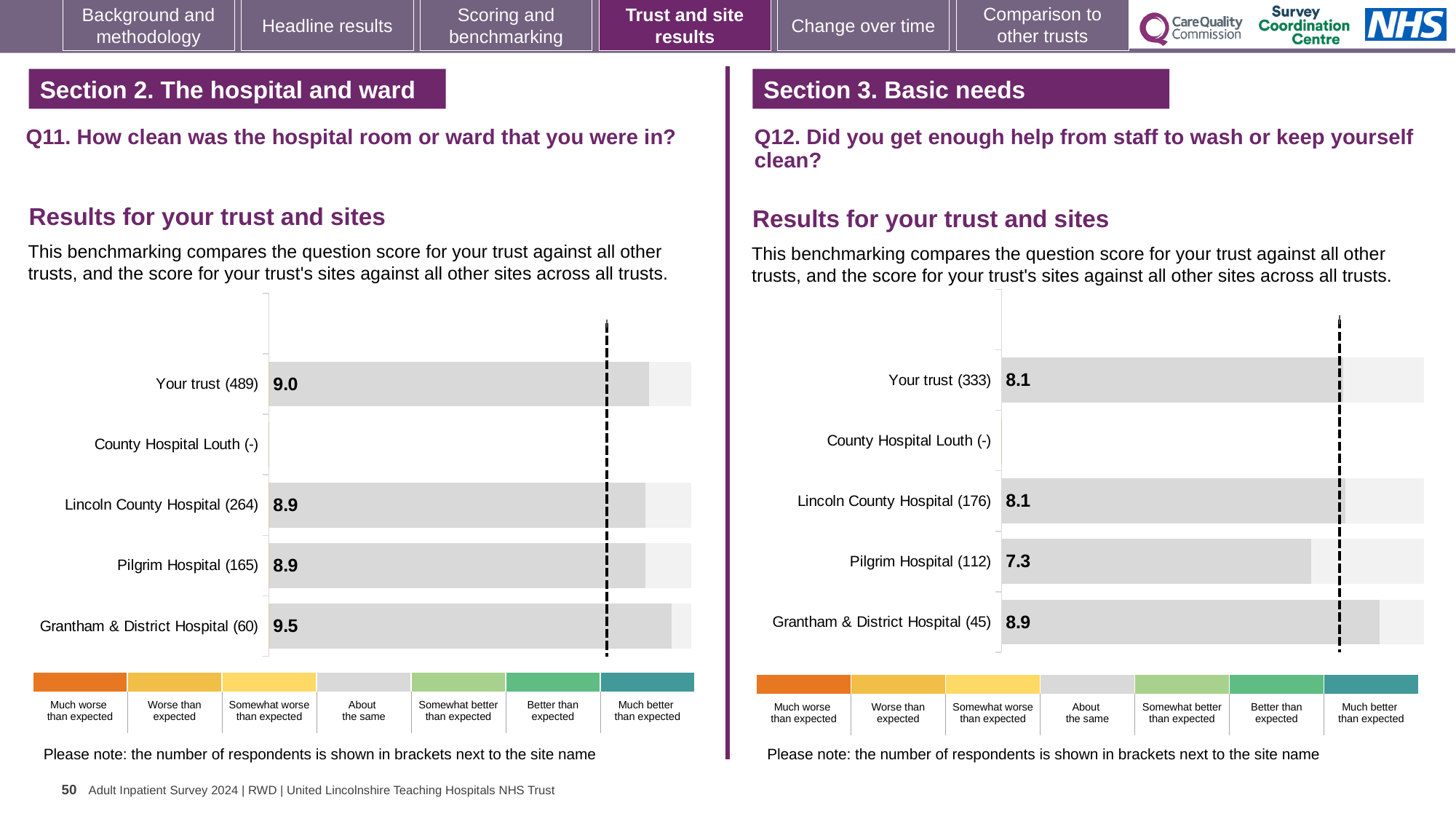
In the Q11 chart on the left, what is the score for Your trust? 9.0 In the Q11 chart on the left, which site has no score shown? County Hospital Louth In the Q12 chart on the right, what is the score for Pilgrim Hospital? 7.3 In the Q12 chart on the right, which site has the lowest score? Pilgrim Hospital In the Q12 chart on the right, which is larger, the score for Grantham & District Hospital or the score for Your trust? Grantham & District Hospital What kind of chart is the Q11 chart on the left? Bar chart How many sites (including Your trust) are listed on the y axis of the Q12 chart on the right? 5 In the Q11 chart on the left, what is the score for Grantham & District Hospital? 9.5 In the Q12 chart on the right, what is the difference between the scores for Grantham & District Hospital and Pilgrim Hospital? 1.6 In the Q11 chart on the left, what is the difference between the scores for Grantham & District Hospital and Lincoln County Hospital? 0.6 In the Q11 chart on the left, which site has the highest score? Grantham & District Hospital In the Q11 chart on the left, how many respondents are shown in brackets for Pilgrim Hospital? 165